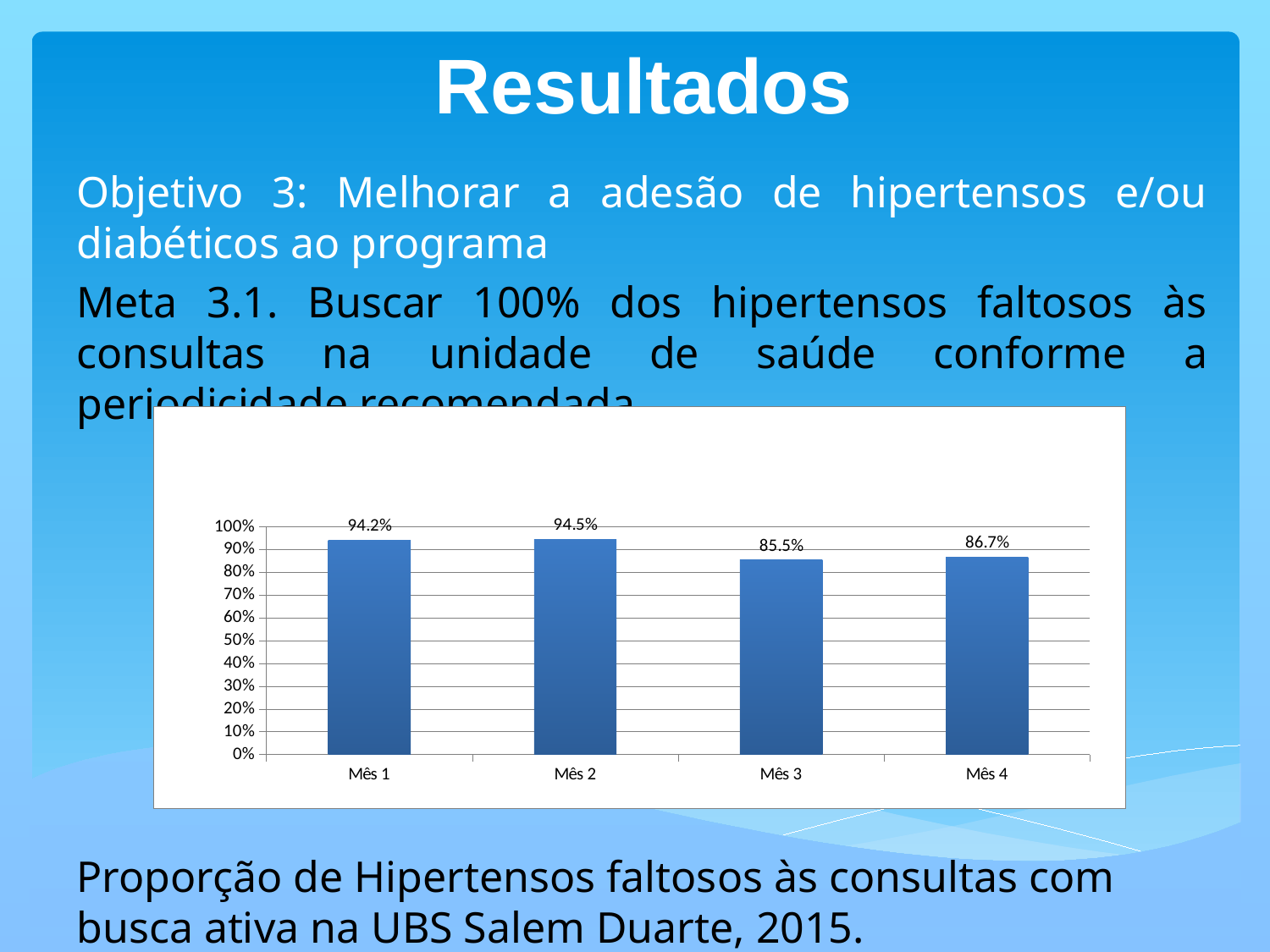
What is the value for Mês 4? 86.7% What is the highest value shown on the y axis? 100% Which is larger, the value for Mês 2 or the value for Mês 4? Mês 2 What is the value for Mês 2? 94.5% How many months are shown on the x axis? 4 Which month has the highest value? Mês 2 What is the difference between the values for Mês 1 and Mês 3? 8.7 percentage points What kind of chart is shown on the slide? bar chart Which month has the lowest value? Mês 3 Is the value for Mês 3 greater or less than 90%? less What is the value for Mês 1? 94.2% What is the value for Mês 3? 85.5%